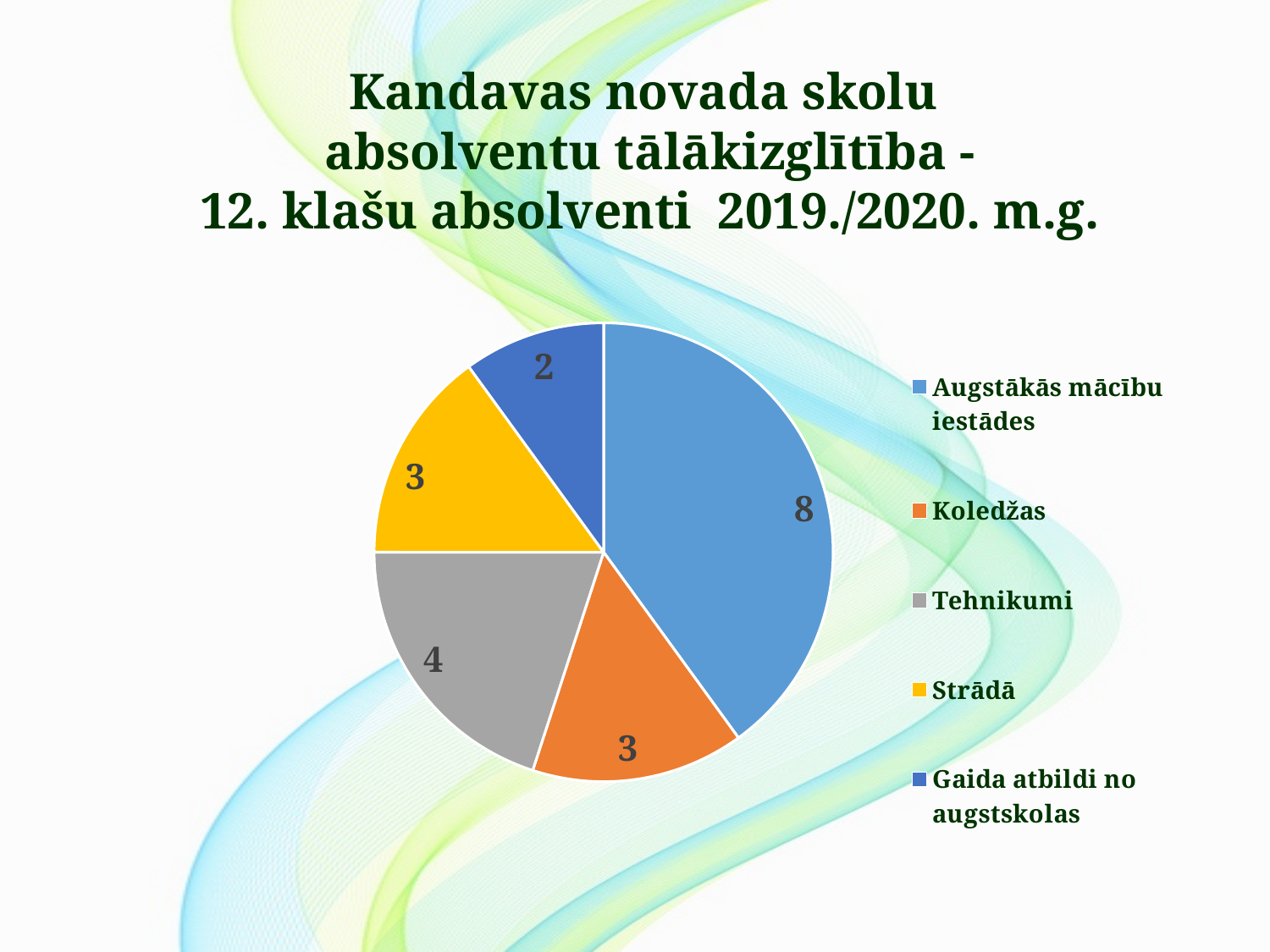
What colour is the slice for Strādā? yellow What is the value for Koledžas? 3 Which category has the smallest slice of the pie? Gaida atbildi no augstskolas What is the difference between the values for Augstākās mācību iestādes and Tehnikumi? 4 What is the value for Tehnikumi? 4 What is the value for Augstākās mācību iestādes? 8 How many categories does the pie chart have? 5 What share of the pie does Augstākās mācību iestādes represent? 40% What type of chart is shown on the slide? pie chart Which is larger, the value for Tehnikumi or the value for Strādā? Tehnikumi What is the value for Gaida atbildi no augstskolas? 2 Which category has the largest slice of the pie? Augstākās mācību iestādes